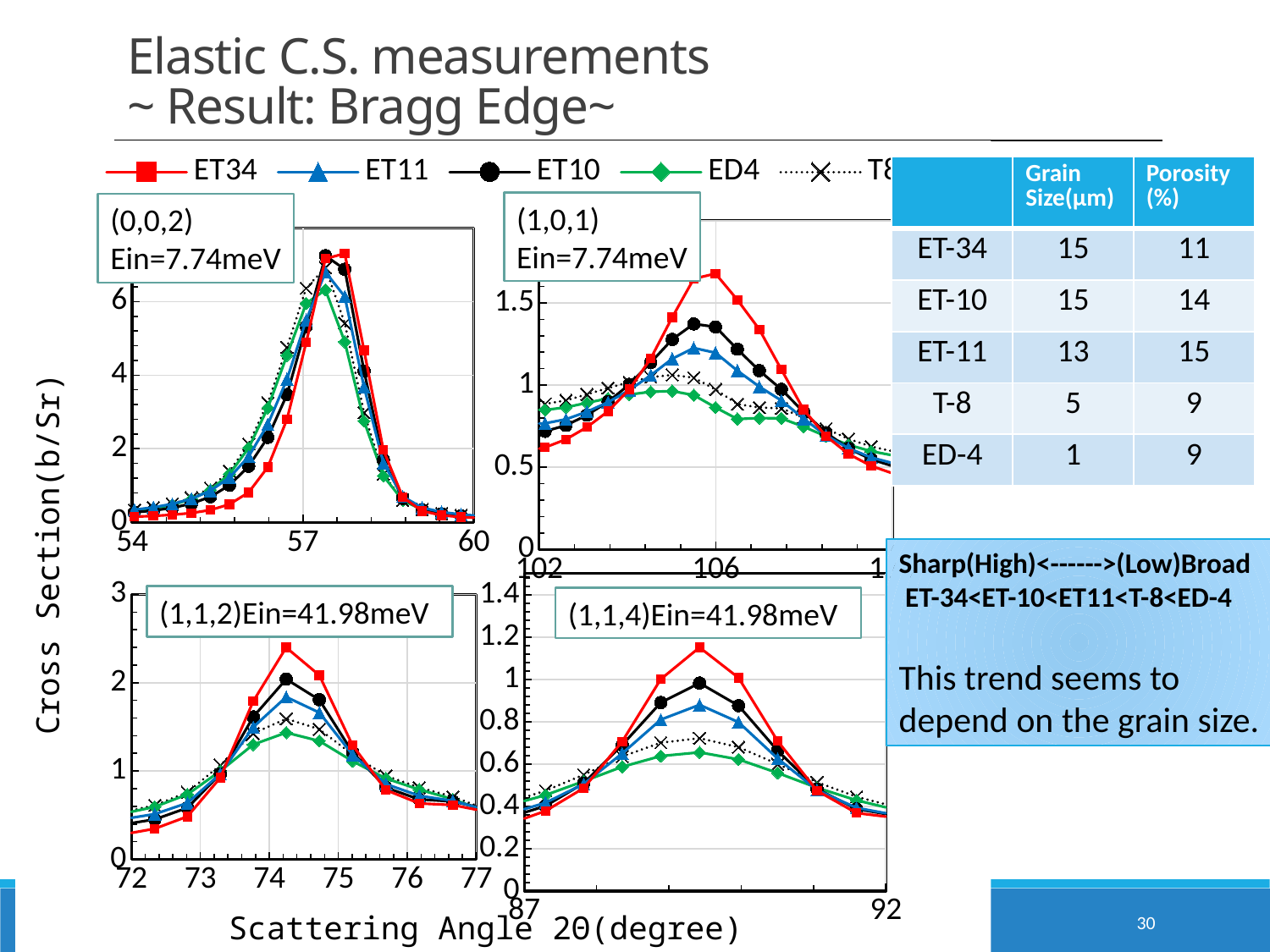
In the (1,0,1) Ein=7.74meV chart, is the peak value of ET34 greater or less than 1.5? greater What kind of chart is the (1,1,2) Ein=41.98meV chart at the bottom left? line chart In the (1,0,1) Ein=7.74meV chart, which peak is higher, ET34 or ED4? ET34 In the (1,1,2) Ein=41.98meV chart, is the peak value of ET34 greater or less than 2? greater In the (1,1,2) Ein=41.98meV chart, which series reaches the highest peak? ET34 In the (1,1,2) Ein=41.98meV chart, is the peak value of ED4 greater or less than 2? less In the (1,1,4) Ein=41.98meV chart, which series reaches the highest peak? ET34 What is the label on the shared vertical axis of the charts? Cross Section(b/Sr) What is the label on the shared horizontal axis of the charts? Scattering Angle 2θ(degree) In the (1,1,2) Ein=41.98meV chart, which series has the lowest peak? ED4 How many series does the legend at the top of the slide list? 5